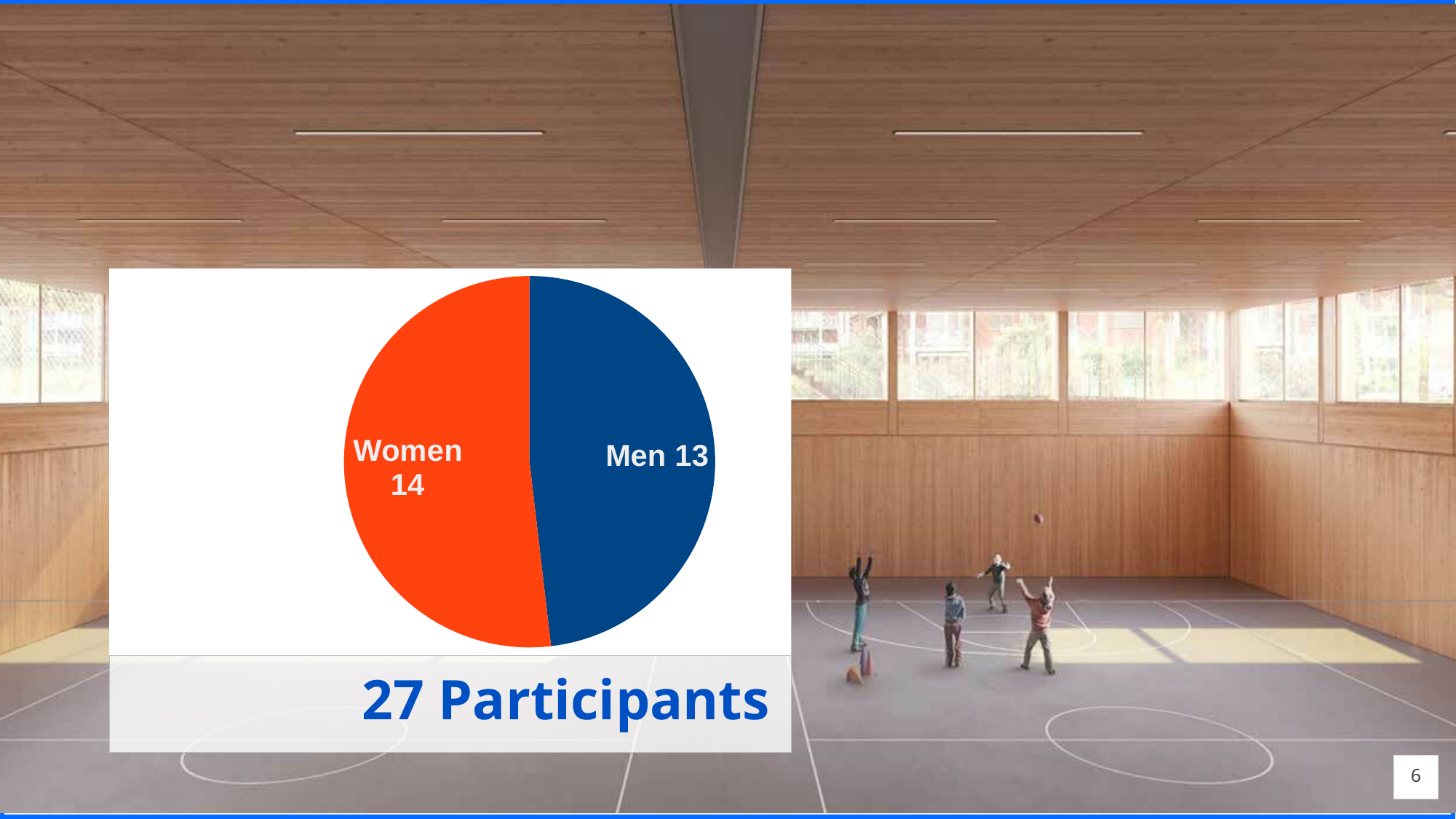
What colour is the Women slice of the pie chart? orange-red Which group has the smaller slice of the pie chart? Men What colour is the Men slice of the pie chart? dark blue What is the total number of participants shown below the pie chart? 27 Participants What kind of chart is shown on the slide? pie chart Which group has the larger slice of the pie chart, Women or Men? Women How many participants are men according to the pie chart? 13 Are there more women or more men among the participants shown in the pie chart? Women What is the difference between the number of women and the number of men in the pie chart? 1 How many participants are women according to the pie chart? 14 How many slices does the pie chart have? 2